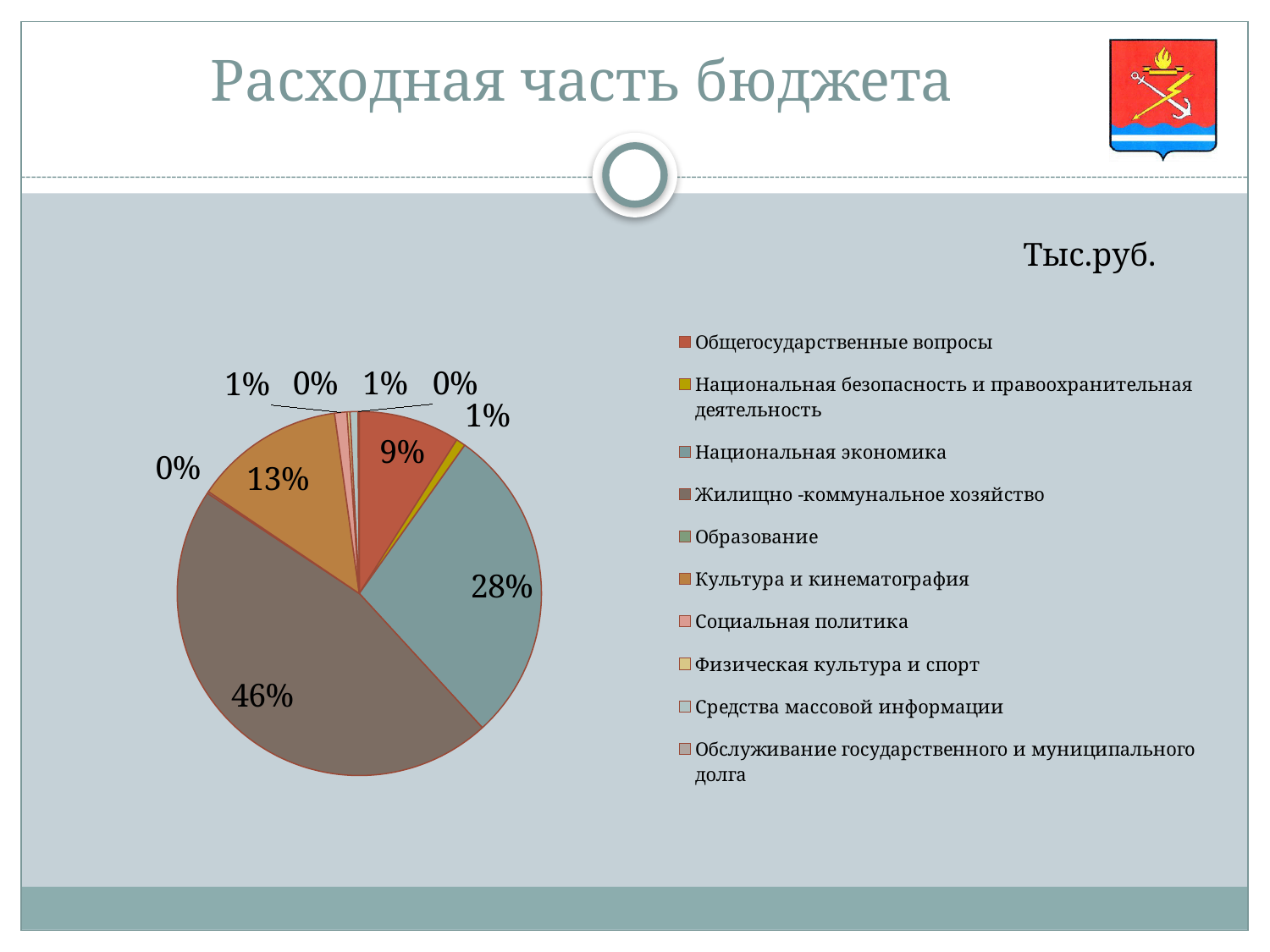
What is the difference in percentage points between the Жилищно-коммунальное хозяйство slice and the Национальная экономика slice? 18% What is the difference in percentage points between the Культура и кинематография slice and the Общегосударственные вопросы slice? 4% What share of the pie does Общегосударственные вопросы take? 9% What is the title of the slide containing the chart? Расходная часть бюджета What kind of chart is shown on the slide? pie chart What share of the pie does Культура и кинематография take? 13% Which category has the largest slice of the pie? Жилищно-коммунальное хозяйство Which is larger, the slice for Национальная экономика or the slice for Культура и кинематография? Национальная экономика What unit is indicated above the legend of the chart? Тыс.руб. How many categories does the legend list? 10 What share of the pie does Жилищно-коммунальное хозяйство take? 46%